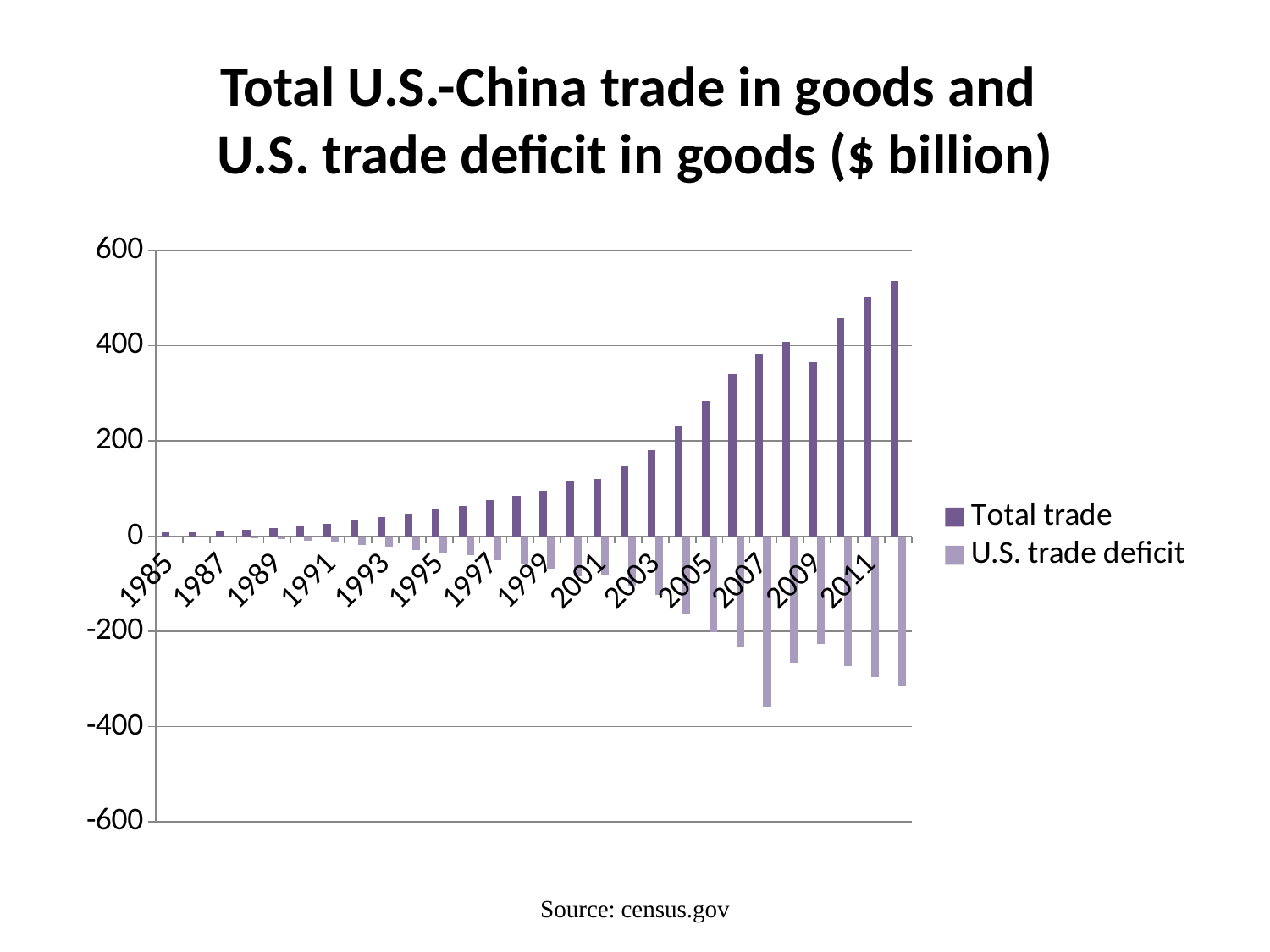
Is the U.S. trade deficit value for 2007 greater or less than -200? less How many series does the legend list? 2 Is the Total trade value for 2005 greater or less than 200? greater What are the two series named in the legend? Total trade and U.S. trade deficit What is the title of the chart? Total U.S.-China trade in goods and U.S. trade deficit in goods ($ billion) Which year has the lowest (most negative) U.S. trade deficit value? 2007 What kind of chart is shown on the slide? bar chart Is the Total trade value for 2009 greater or less than 400? less Which year has the larger Total trade value, 2009 or 2011? 2011 Does the Total trade series generally rise or fall from 1985 onward? rise